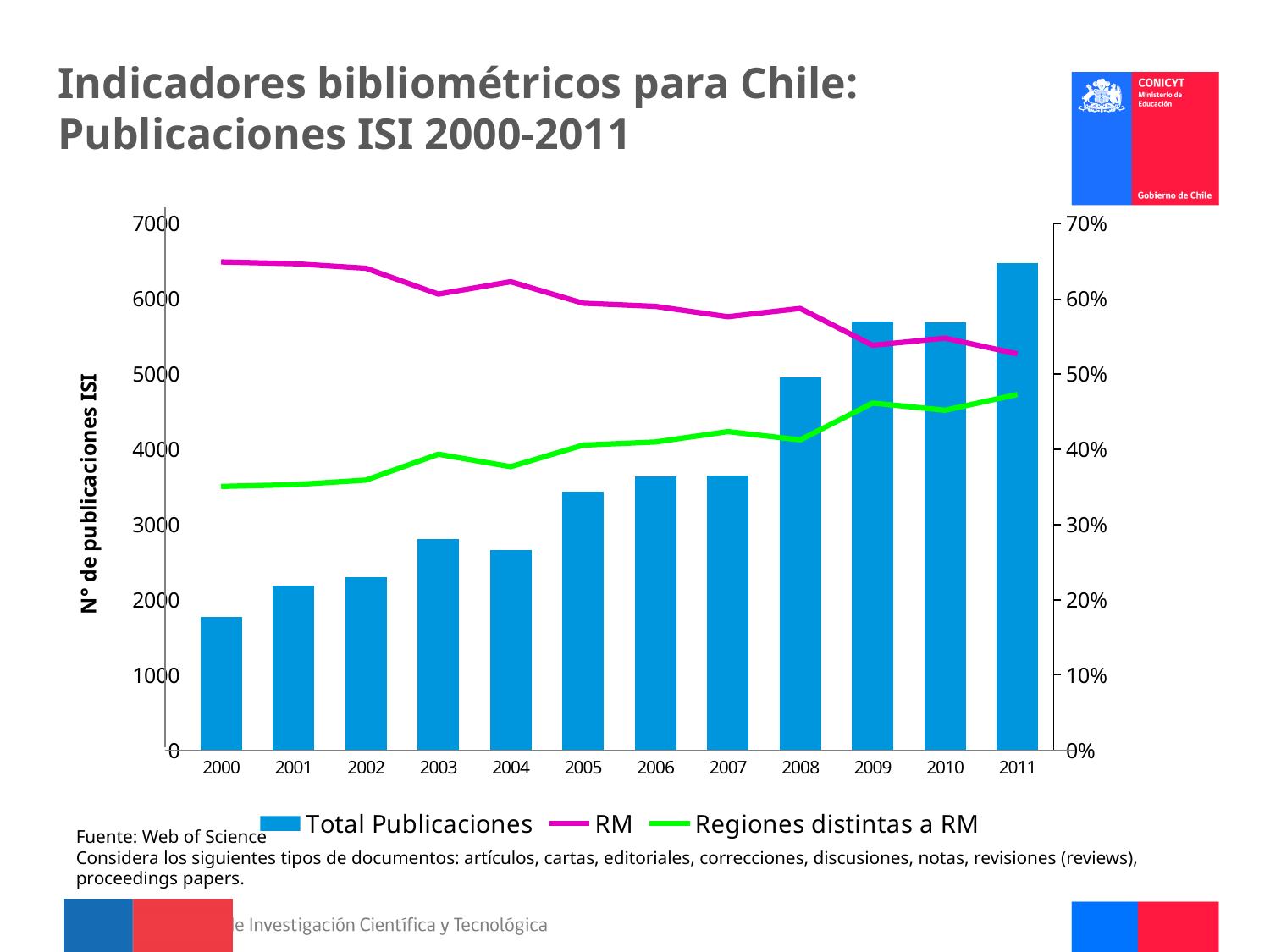
Which is larger, the Total Publicaciones bar for 2004 or for 2005? 2005 What is the label of the left vertical axis? N° de publicaciones ISI Is the RM value for 2000 greater or less than 60%? greater Is the Total Publicaciones value for 2008 greater or less than 4000? greater What kind of chart is shown on the slide? bar and line chart Does the RM line rise or fall from 2000 to 2011? fall Which year has the highest bar for Total Publicaciones? 2011 How many years are shown on the x axis? 12 Do the Total Publicaciones bars generally rise or fall from 2000 to 2011? rise Which year has the lowest bar for Total Publicaciones? 2000 How many series does the legend list? 3 Is the Total Publicaciones value for 2000 greater or less than 2000? less